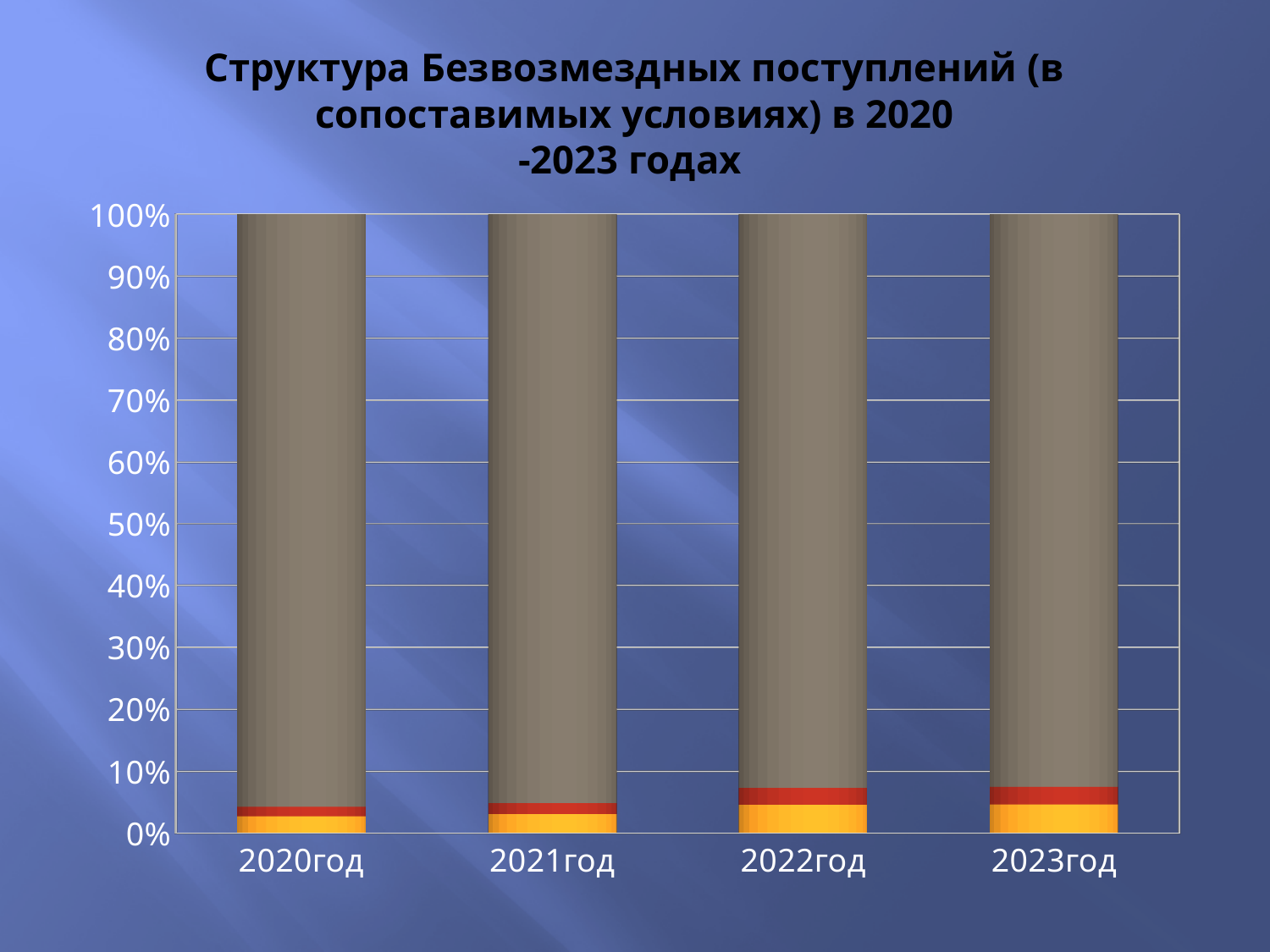
What is the last category label on the x axis of the chart? 2023год How many years (categories) are shown on the x axis of the chart? 4 Which colour segment is the largest in every bar of the chart? grey Is the yellow segment of the 2020год bar greater or less than 10%? less What kind of chart is shown on the slide? stacked bar chart Is the combined red and yellow portion of the 2023год bar greater or less than 10%? less Is the yellow segment of the 2023год bar greater or less than 10%? less What is the highest value shown on the vertical axis of the chart? 100% What is the first category label on the x axis of the chart? 2020год What is the title of the chart on the slide? Структура Безвозмездных поступлений (в сопоставимых условиях) в 2020 -2023 годах